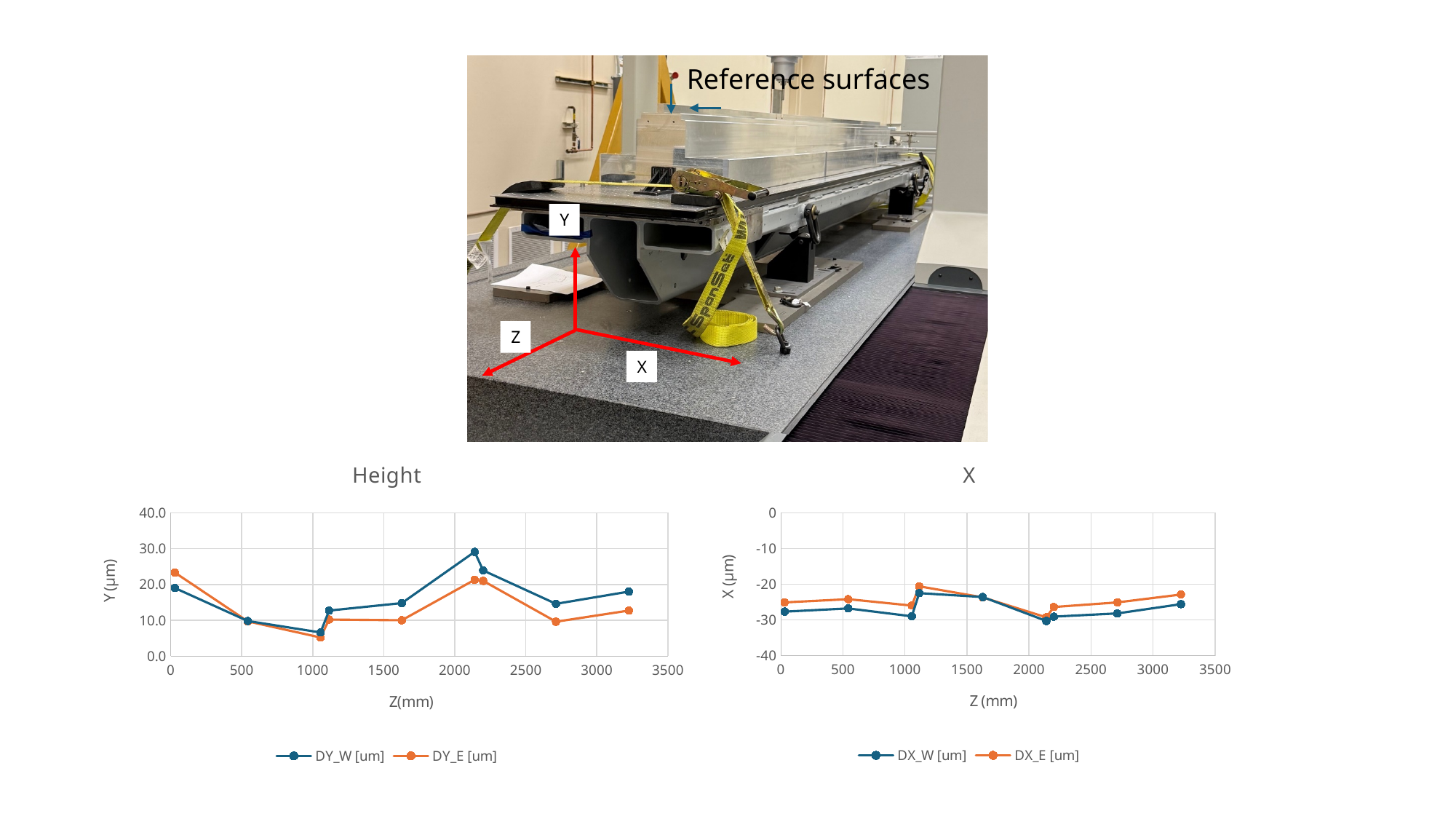
In the "Height" chart, is the value of DY_E near Z = 1000 greater or less than 10.0? less In the "X" chart, near Z = 1100, which series has the larger (less negative) value, DX_W or DX_E? DX_E [um] What is the x-axis label of the "X" chart? Z (mm) In the "Height" chart, which series reaches the highest value overall? DY_W [um] What are the two series named in the legend of the "Height" chart? DY_W [um] and DY_E [um] How many series does the legend of the "X" chart list? 2 What kind of chart is the "Height" chart? line chart In the "Height" chart, do the DY_W values rise or fall between Z = 0 and Z = 1000? fall In the "X" chart, do the DX_E values rise or fall between Z = 2200 and Z = 3200? rise In the "X" chart, is the value of DX_W near Z = 2100 greater or less than -20? less In the "Height" chart, at the first point (Z near 0), which series has the larger value, DY_W or DY_E? DY_E [um] In the "Height" chart, is the peak value of DY_W (near Z = 2100) greater or less than 20.0? greater